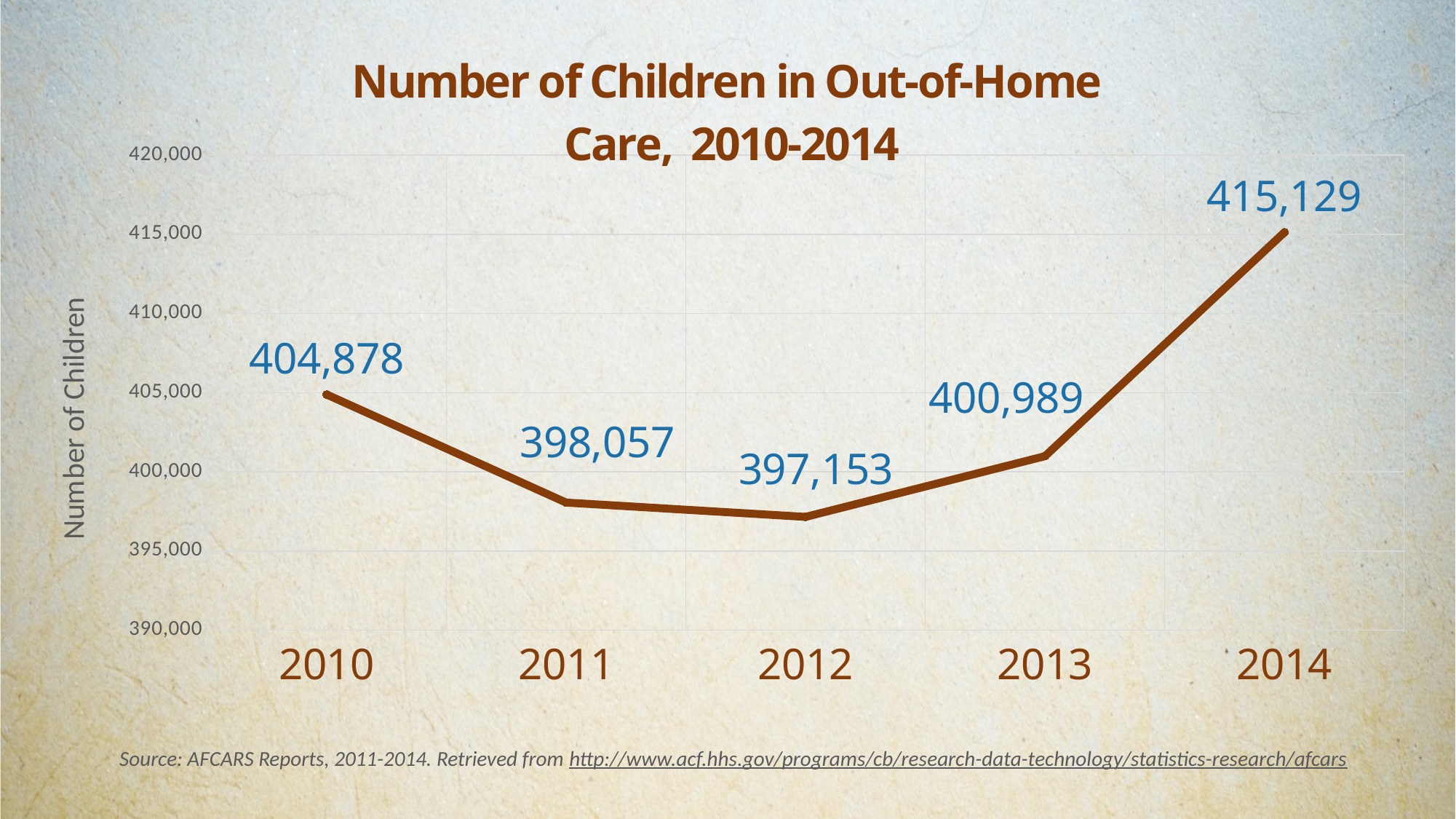
Which year had the lowest number of children in out-of-home care? 2012 How much did the number of children in out-of-home care increase from 2013 to 2014? 14,140 What is the label on the vertical axis of the chart? Number of Children What was the number of children in out-of-home care in 2012? 397,153 What kind of chart is shown on the slide? line chart Which year had the highest number of children in out-of-home care? 2014 How many years are plotted on the chart? 5 Is the value for 2013 greater or less than 405,000? less Which year had more children in out-of-home care, 2011 or 2013? 2013 What was the number of children in out-of-home care in 2014? 415,129 What is the difference between the 2010 and 2011 values? 6,821 What was the number of children in out-of-home care in 2010? 404,878